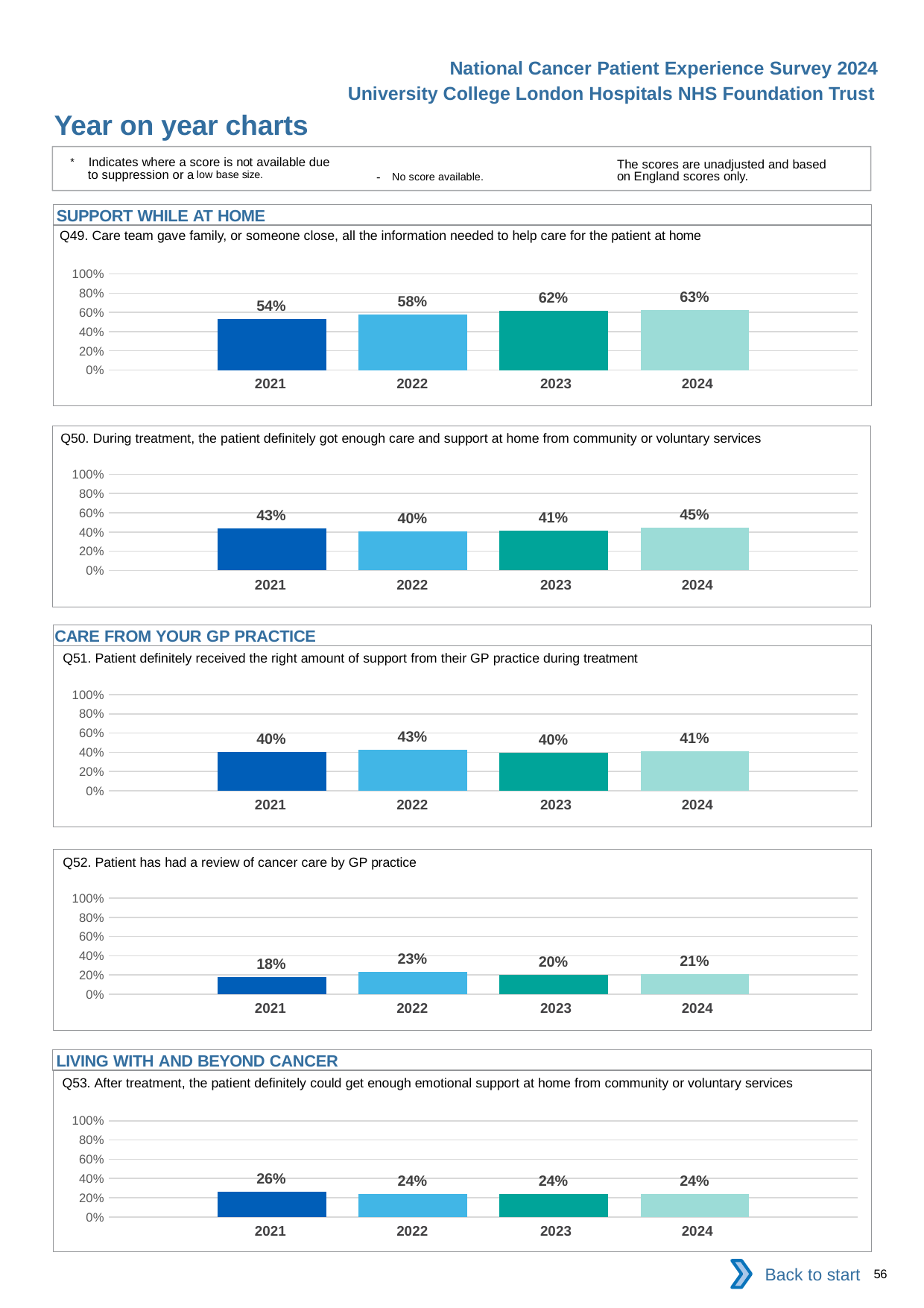
In the Q49 chart, which year has the lowest value? 2021 What type of chart is the Q53 chart? bar chart In the Q49 chart, do the values rise or fall from 2021 to 2024? rise In the Q51 chart, what is the value for 2022? 43% In the Q53 chart, how many years are plotted? 4 In the Q50 chart, what is the difference between the 2024 and 2022 values? 5% In the Q50 chart, what is the value for 2022? 40% In the Q50 chart, which year has the highest value? 2024 In the Q52 chart, which is larger, the value for 2022 or the value for 2024? 2022 In the Q49 chart, what is the value for 2024? 63% In the Q51 chart, is the value for 2023 greater or less than 60%? less In the Q52 chart, what is the value for 2021? 18%